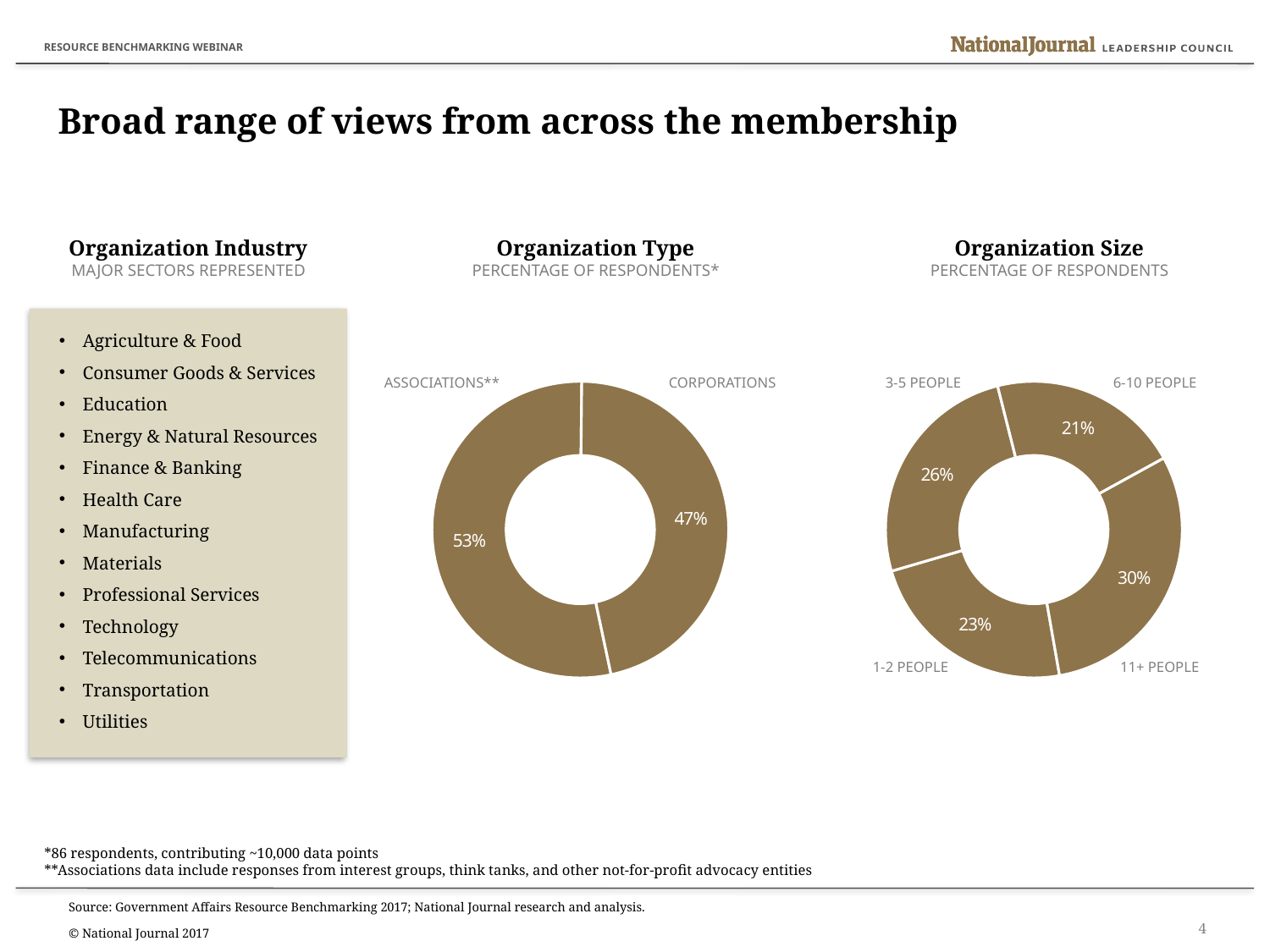
In the Organization Size chart, what percentage of respondents have 11+ people? 30% In the Organization Size chart, what percentage of respondents have 1-2 people? 23% In the Organization Size chart, what percentage of respondents have 6-10 people? 21% In the Organization Type chart, what percentage of respondents are corporations? 47% In the Organization Size chart, what is the difference in percentage points between the 11+ people and 6-10 people categories? 9 percentage points In the Organization Type chart, which is larger: the share of associations or the share of corporations? Associations In the Organization Type chart, what is the difference in percentage points between associations and corporations? 6 percentage points What kind of chart is the Organization Type chart? Doughnut (pie) chart In the Organization Size chart, which organization size has the smallest share of respondents? 6-10 people In the Organization Type chart, what percentage of respondents are associations? 53% How many categories are shown in the Organization Size chart? 4 In the Organization Size chart, which organization size has the largest share of respondents? 11+ people